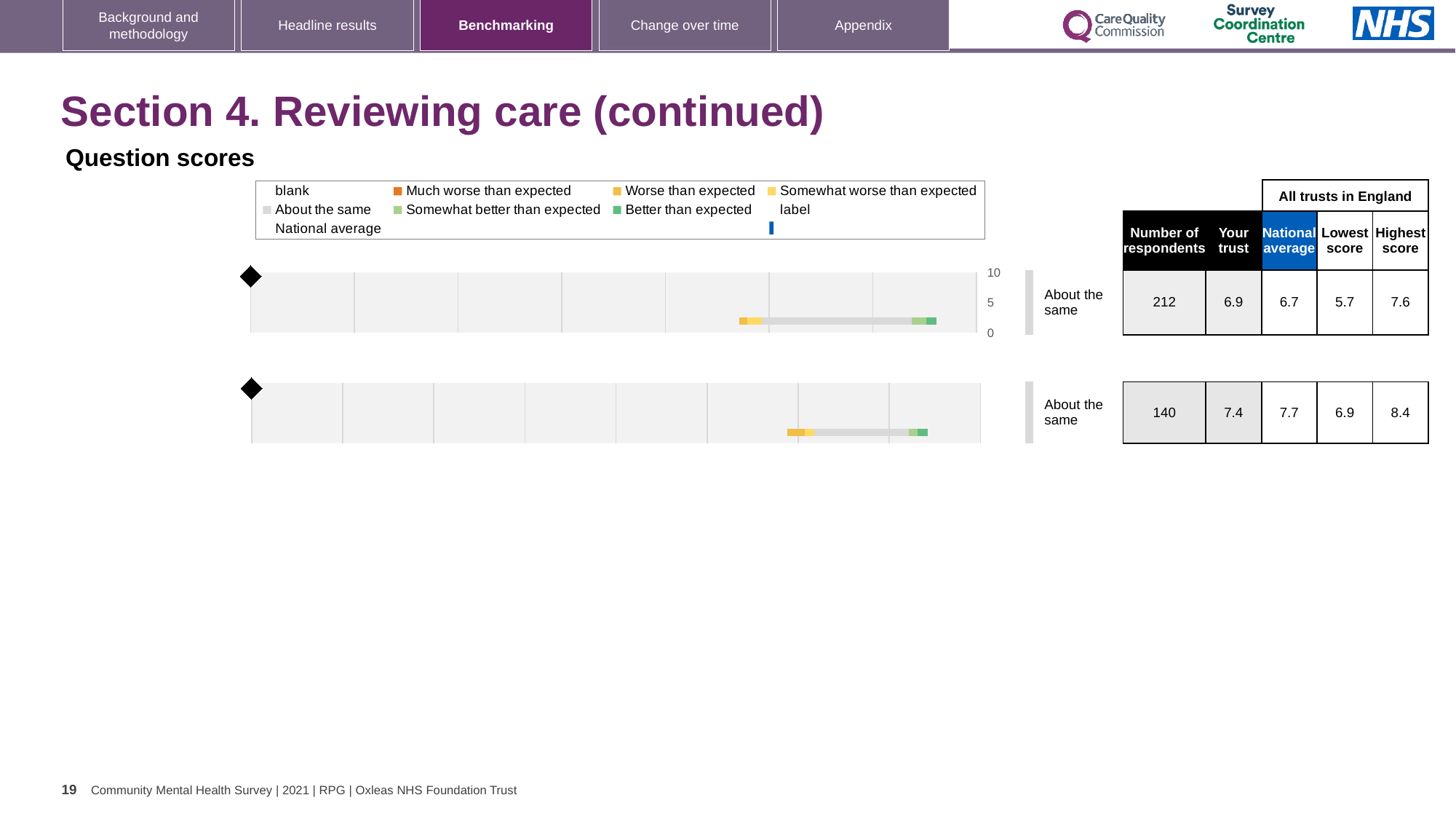
What is the highest value shown on the vertical axis scale next to the top chart? 10 What kind of chart is used on this slide to show the question scores? bar chart For the top chart's row, what is the difference between the highest score and the lowest score? 1.9 For the bottom chart's row, which is larger: the 'Your trust' score or the national average? National average For the top chart's row, what is the number of respondents shown in the table? 212 For the top chart's row, what is the 'Your trust' score? 6.9 For the top chart's row, which is larger: the 'Your trust' score or the national average? Your trust What benchmark category label is shown beside the bottom chart? About the same For the bottom chart's row, what is the national average score? 7.7 How many benchmarking bar charts are shown on the slide? 2 For the bottom chart's row, what is the highest score among all trusts in England? 8.4 In the legend, which category is shown in orange? Much worse than expected